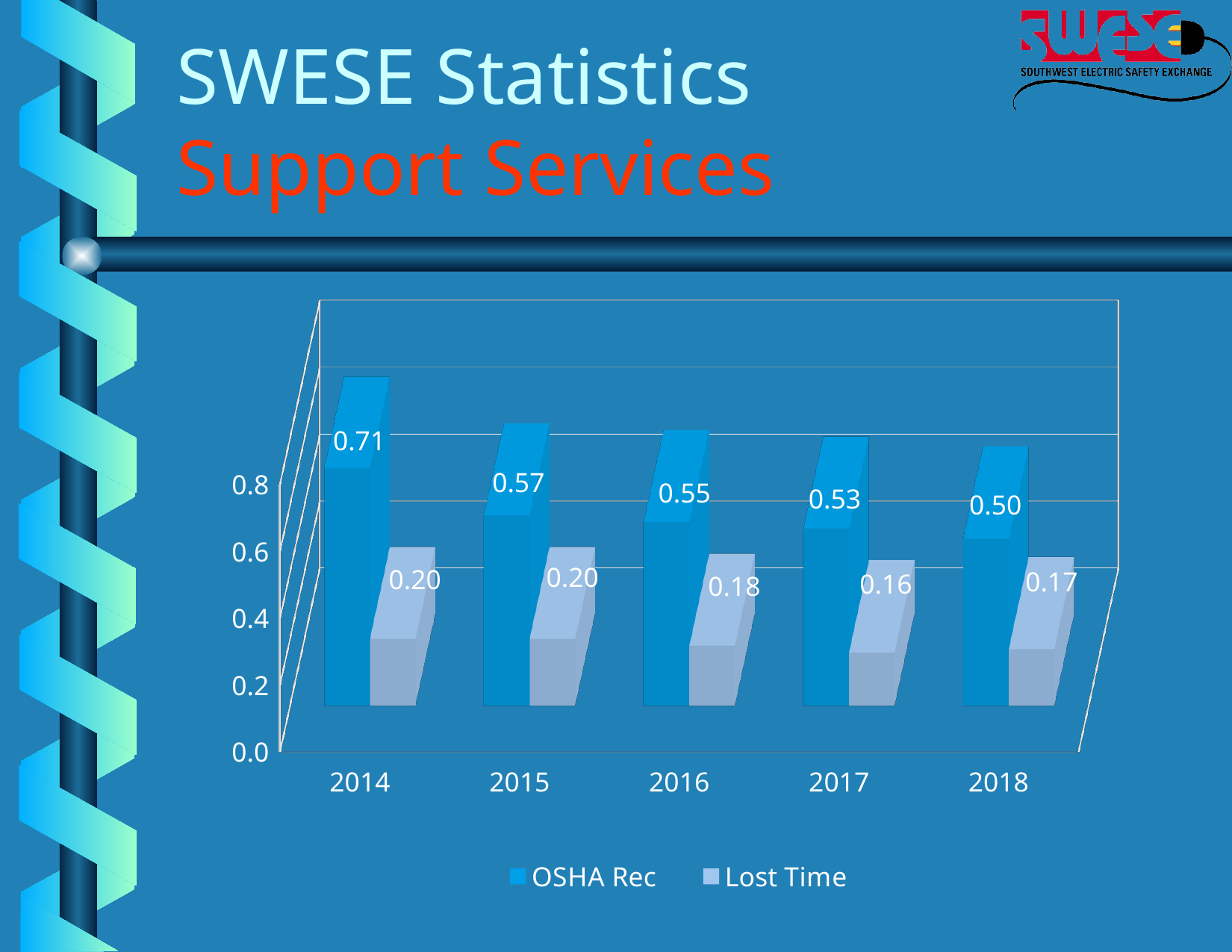
Which is larger, the OSHA Rec value for 2016 or the OSHA Rec value for 2017? 2016 Which year has the highest OSHA Rec value? 2014 What is the difference between the OSHA Rec value and the Lost Time value in 2015? 0.37 How many years are shown on the x axis? 5 Do the OSHA Rec values rise or fall from 2014 to 2018? fall What kind of chart is shown on the slide? bar chart Which year has the lowest Lost Time value? 2017 What is the OSHA Rec value for 2018? 0.50 What is the Lost Time value for 2016? 0.18 How many series does the legend list? 2 What are the two series named in the legend? OSHA Rec and Lost Time What is the OSHA Rec value for 2014? 0.71